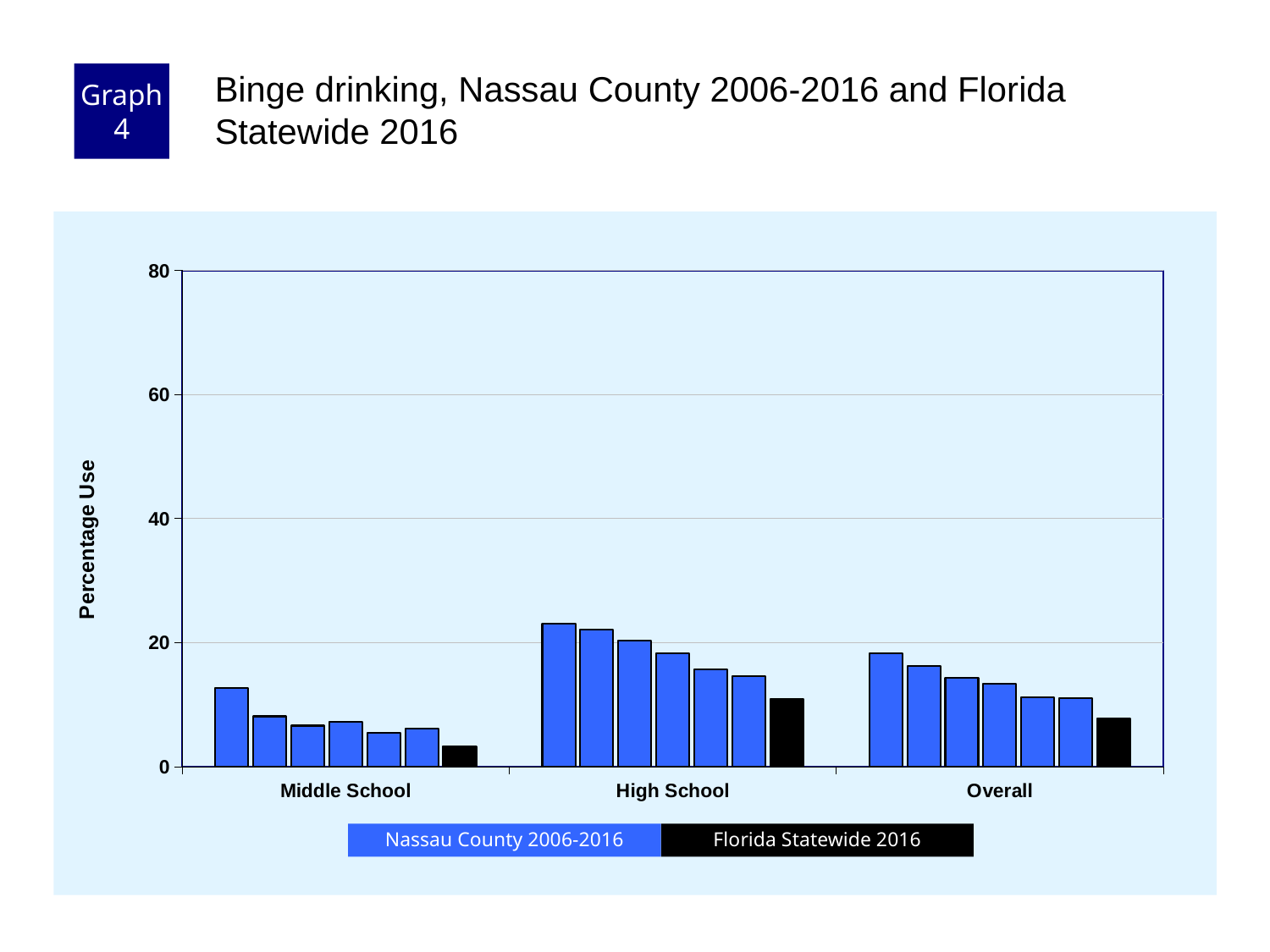
How many series does the legend list? 2 What is the label on the y axis? Percentage Use Is the Florida Statewide 2016 bar for Middle School greater or less than 20? less Which is larger for High School: the Florida Statewide 2016 bar or the first Nassau County 2006-2016 bar? the first Nassau County 2006-2016 bar Within the High School group, do the Nassau County 2006-2016 bars generally rise or fall from left to right? fall Is the tallest Nassau County bar for High School greater or less than 20? greater How many categories are shown on the x axis? 3 What colour represents Florida Statewide 2016 in the legend? black What kind of chart is shown on the slide? bar chart Which category has the highest bars overall? High School Which category has the lowest bars overall? Middle School Is the Florida Statewide 2016 bar for Overall greater or less than 20? less